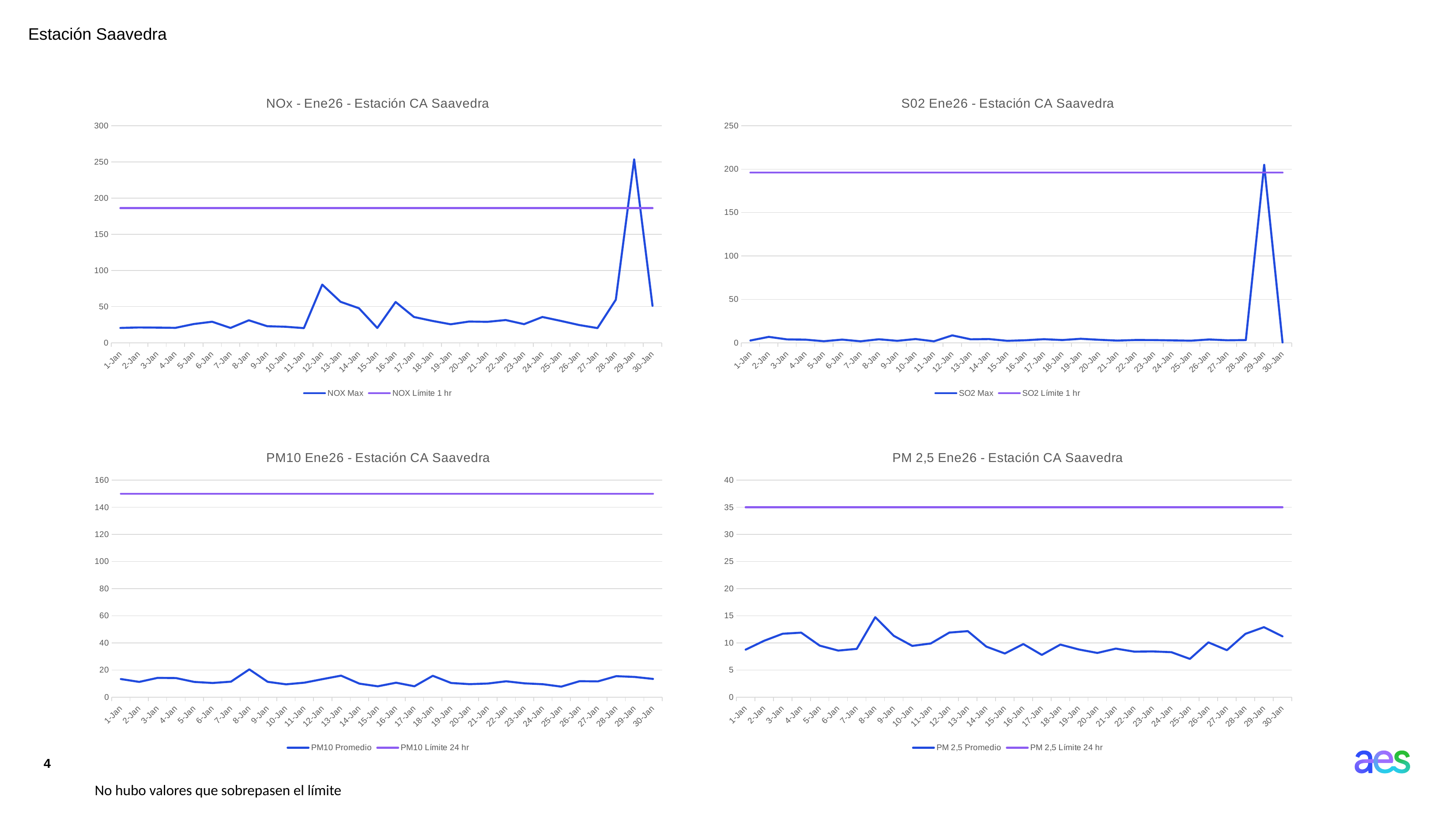
In the 'S02 Ene26 - Estación CA Saavedra' chart, on which date does SO2 Max peak? 29-Jan In the 'NOx - Ene26 - Estación CA Saavedra' chart, which is larger, the NOX Max value for 12-Jan or for 16-Jan? 12-Jan In the 'PM10 Ene26 - Estación CA Saavedra' chart, on which date does PM10 Promedio reach its highest value? 8-Jan In the 'NOx - Ene26 - Estación CA Saavedra' chart, on which date does NOX Max reach its highest value? 29-Jan In the 'NOx - Ene26 - Estación CA Saavedra' chart, is the NOX Max value for 29-Jan greater or less than 200? greater In the 'S02 Ene26 - Estación CA Saavedra' chart, is the SO2 Max value for 29-Jan greater or less than 150? greater In the 'PM 2,5 Ene26 - Estación CA Saavedra' chart, is the PM 2,5 Promedio value for 8-Jan greater or less than 10? greater What kind of chart is the 'NOx - Ene26 - Estación CA Saavedra' chart? line chart In the 'PM 2,5 Ene26 - Estación CA Saavedra' chart, what is the value of the PM 2,5 Límite 24 hr line? 35 How many series does the legend of the 'S02 Ene26 - Estación CA Saavedra' chart list? 2 How many dates are plotted along the x axis of the 'PM10 Ene26 - Estación CA Saavedra' chart? 30